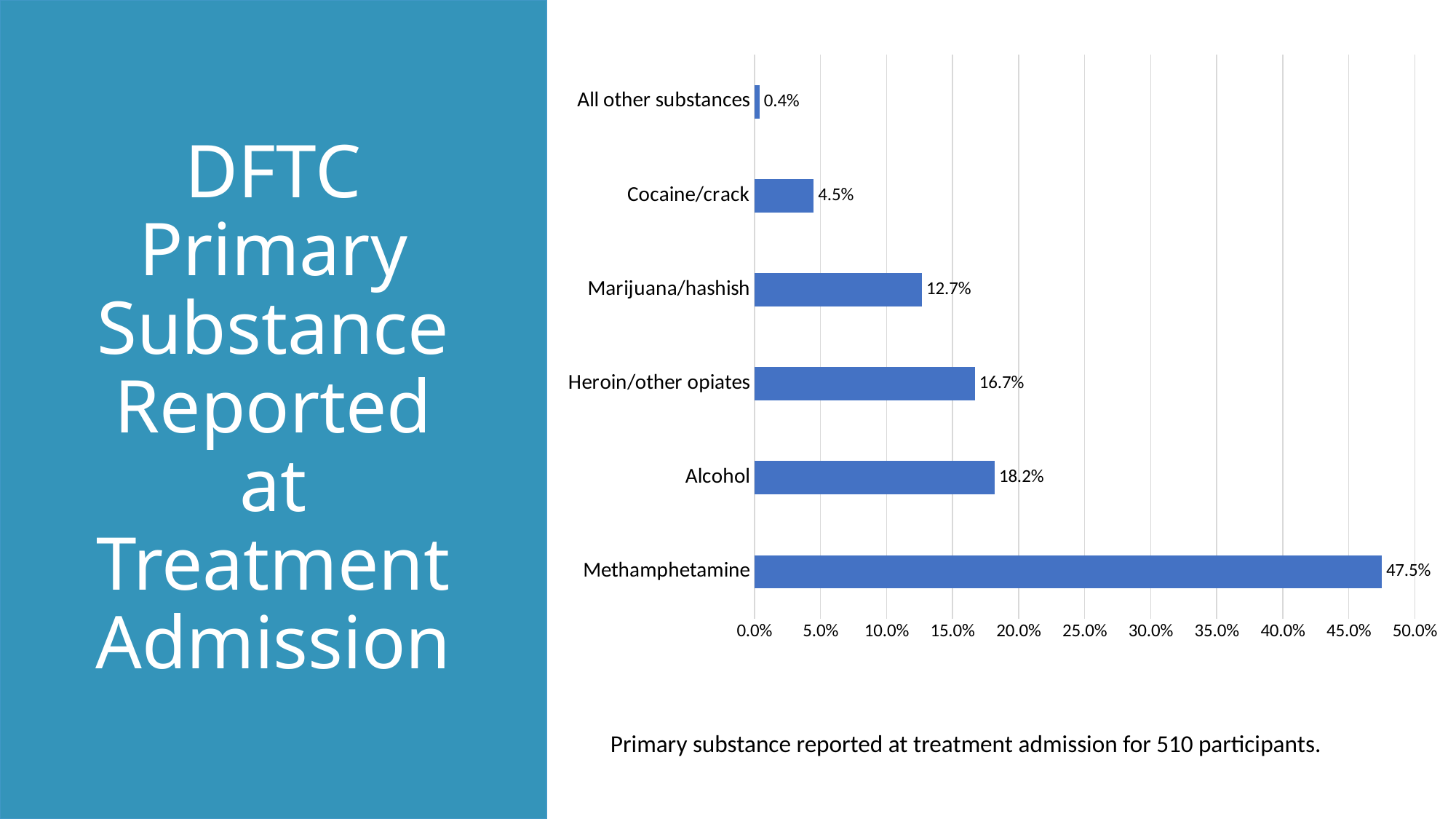
Which substance has the highest percentage? Methamphetamine According to the caption below the chart, how many participants are included? 510 What is the value shown for Alcohol? 18.2% What is the value shown for Cocaine/crack? 4.5% What kind of chart is shown on the slide? Bar chart Which is larger, the value for Alcohol or the value for Heroin/other opiates? Alcohol What is the value shown for Heroin/other opiates? 16.7% What is the difference between the Methamphetamine and Alcohol percentages? 29.3% Which category has the lowest percentage? All other substances What percentage of participants reported methamphetamine as their primary substance? 47.5% How many substance categories are shown in the chart? 6 What is the difference between the Marijuana/hashish and Cocaine/crack percentages? 8.2%